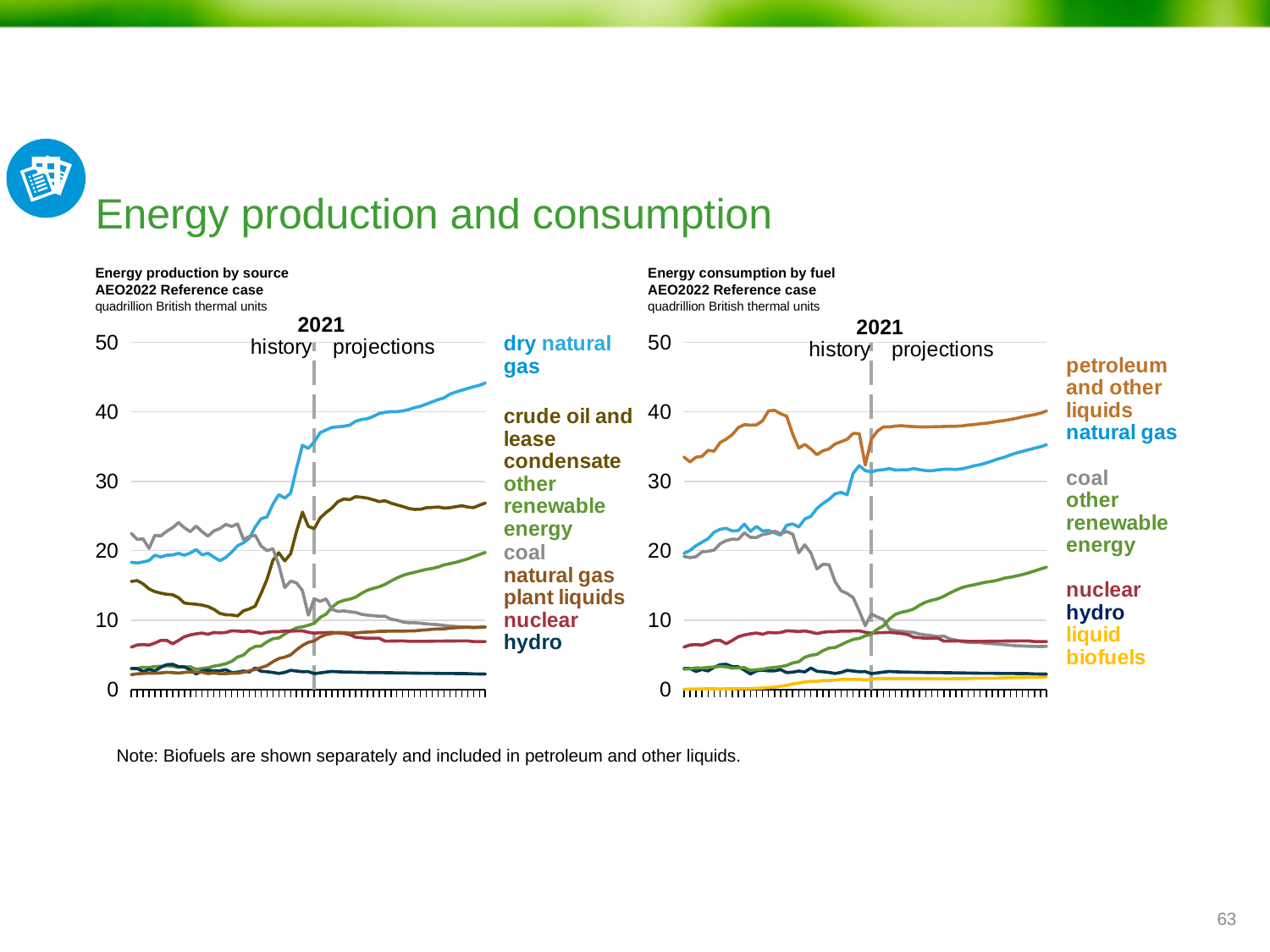
How many series are labelled on the 'Energy consumption by fuel' chart on the right? 7 On the 'Energy production by source' chart, which is larger at the end of the projection period: other renewable energy or coal? other renewable energy How many series are labelled on the 'Energy production by source' chart on the left? 7 On the 'Energy consumption by fuel' chart, is the value for coal at the end of the projection period greater or less than 10? less What unit is used on the y axis of both charts? quadrillion British thermal units What kind of chart is the 'Energy production by source' chart on the left? line chart On the 'Energy production by source' chart, is the value for dry natural gas at the end of the projection period greater or less than 40? greater Which year does the dashed vertical line separating history from projections mark on both charts? 2021 On the 'Energy production by source' chart, does the coal line rise or fall over the projection period? fall On the 'Energy consumption by fuel' chart, which fuel has the highest value at the end of the projection period? petroleum and other liquids On the 'Energy production by source' chart, which source has the highest value at the end of the projection period? dry natural gas On the 'Energy consumption by fuel' chart, does the other renewable energy line rise or fall over the projection period? rise